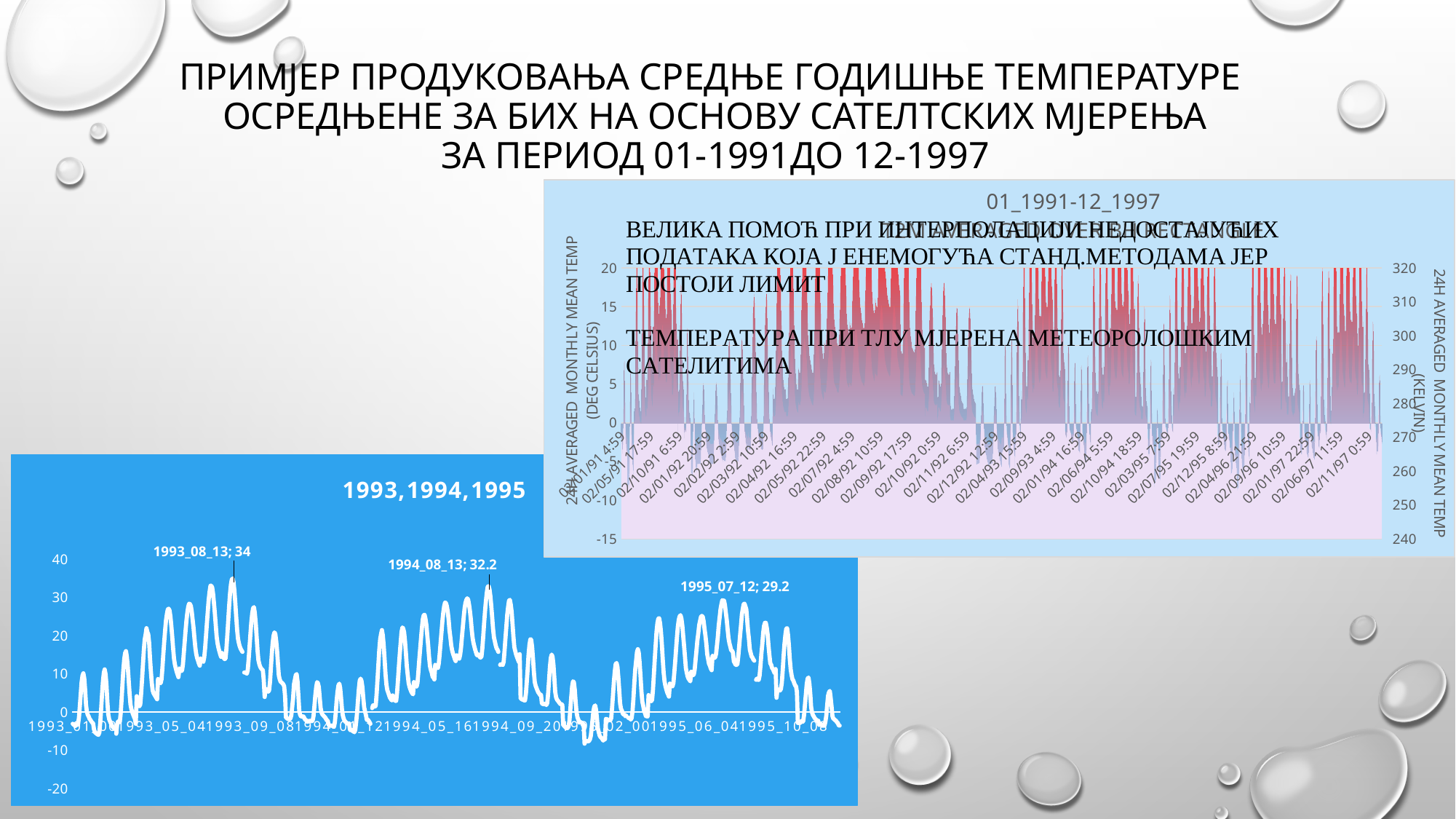
What kind of chart is the one titled "01_1991-12_1997" at the top right of the slide? Area chart In the chart titled "1993, 1994, 1995", what value is labelled at 1994_08_13? 32.2 In the chart titled "01_1991-12_1997", what unit is shown on the right-hand vertical axis? Kelvin In the chart titled "1993, 1994, 1995", what value is labelled at 1993_08_13? 34 In the chart titled "01_1991-12_1997", what is the label of the left-hand vertical axis? 24H AVERAGED MONTHLY MEAN TEMP (DEG CELSIUS) In the chart titled "1993, 1994, 1995", what is the difference between the labelled peak values at 1993_08_13 and 1994_08_13? 1.8 In the chart titled "1993, 1994, 1995", which of the three labelled peaks has the lowest value? 1995_07_12 In the chart titled "1993, 1994, 1995", what value is labelled at 1995_07_12? 29.2 In the chart titled "1993, 1994, 1995", what is the difference between the labelled peak values at 1993_08_13 and 1995_07_12? 4.8 In the chart titled "1993, 1994, 1995", which labelled peak is larger, 1994_08_13 or 1995_07_12? 1994_08_13 In the chart titled "1993, 1994, 1995", which of the three labelled peaks has the highest value? 1993_08_13 What kind of chart is the one titled "1993, 1994, 1995" at the bottom left of the slide? Line chart